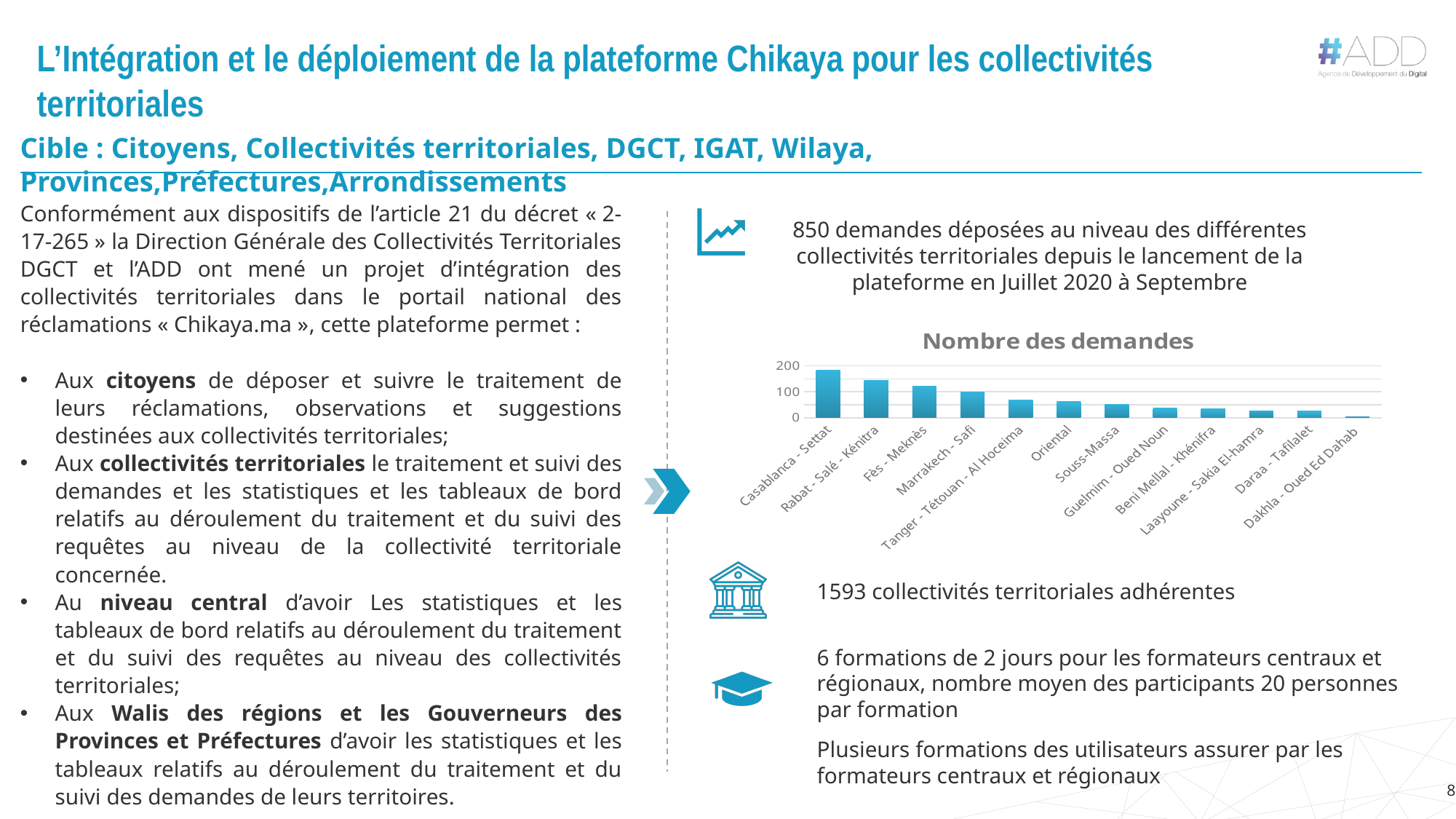
Which region has the highest number of demandes? Casablanca - Settat Which has more demandes, Fès - Meknès or Oriental? Fès - Meknès What is the title of the chart? Nombre des demandes Is the value for Tanger - Tétouan - Al Hoceima greater or less than 100? less Which region has the lowest number of demandes? Dakhla - Oued Ed Dahab Do the values rise or fall from left to right along the x axis? fall Is the value for Casablanca - Settat greater or less than 100? greater Which has more demandes, Casablanca - Settat or Rabat - Salé - Kénitra? Casablanca - Settat What kind of chart is shown on the slide? bar chart Is the value for Dakhla - Oued Ed Dahab greater or less than 100? less How many regions (categories) are shown in the chart? 12